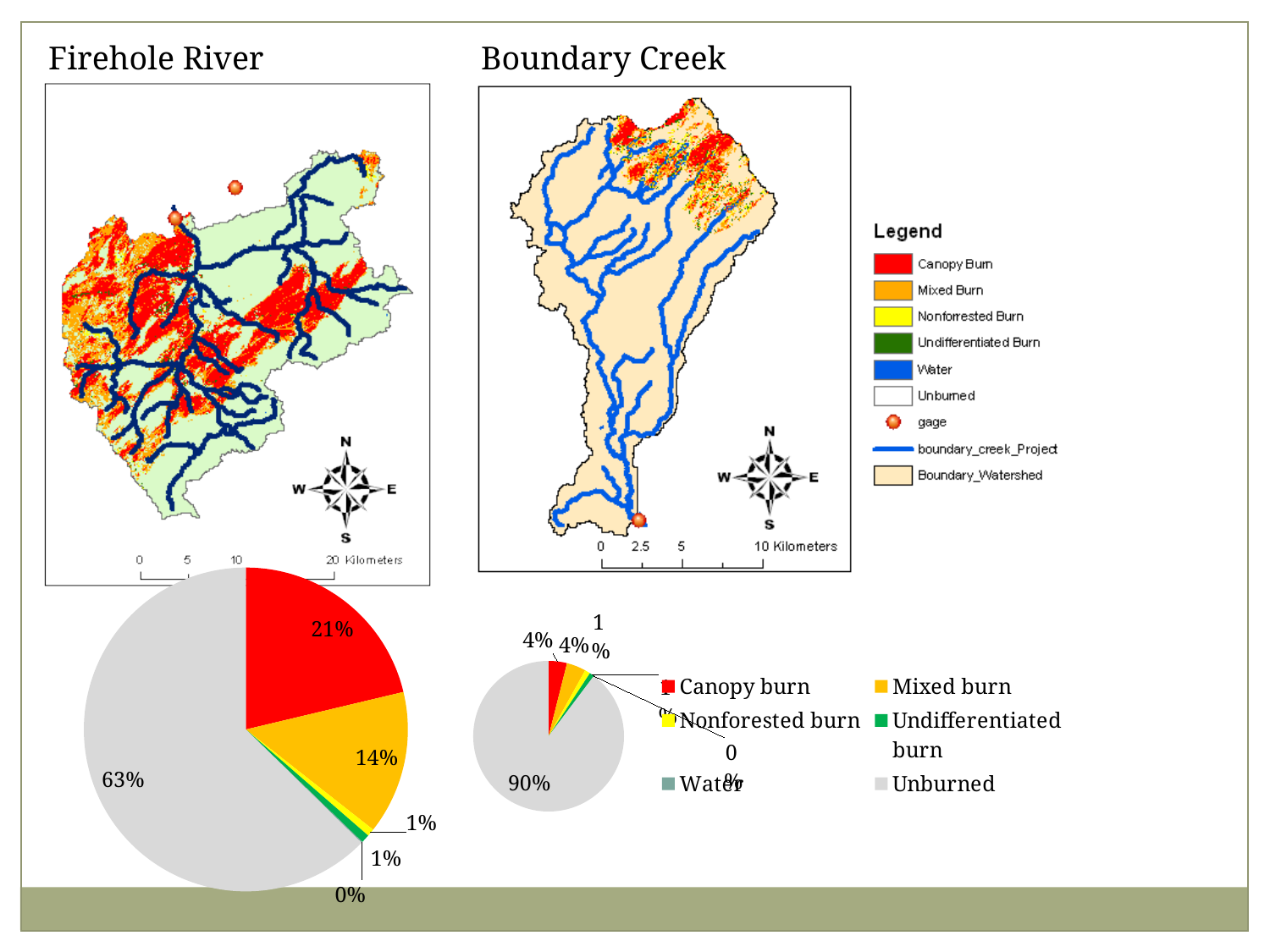
How many categories does the pie chart legend list? 6 In the Firehole River pie chart, which is larger, Canopy burn or Mixed burn? Canopy burn In the Boundary Creek pie chart, what share is Canopy burn? 4% In the Firehole River pie chart, what share is Mixed burn? 14% In the Firehole River pie chart, which category has the largest slice? Unburned In the Boundary Creek pie chart, what share is Unburned? 90% Which watershed has the larger Canopy burn share, Firehole River or Boundary Creek? Firehole River In the Boundary Creek pie chart, which category has the largest slice? Unburned What type of chart is used to show the burn shares for Firehole River and Boundary Creek? Pie chart In the Firehole River pie chart, what is the difference between the Canopy burn and Mixed burn shares? 7%